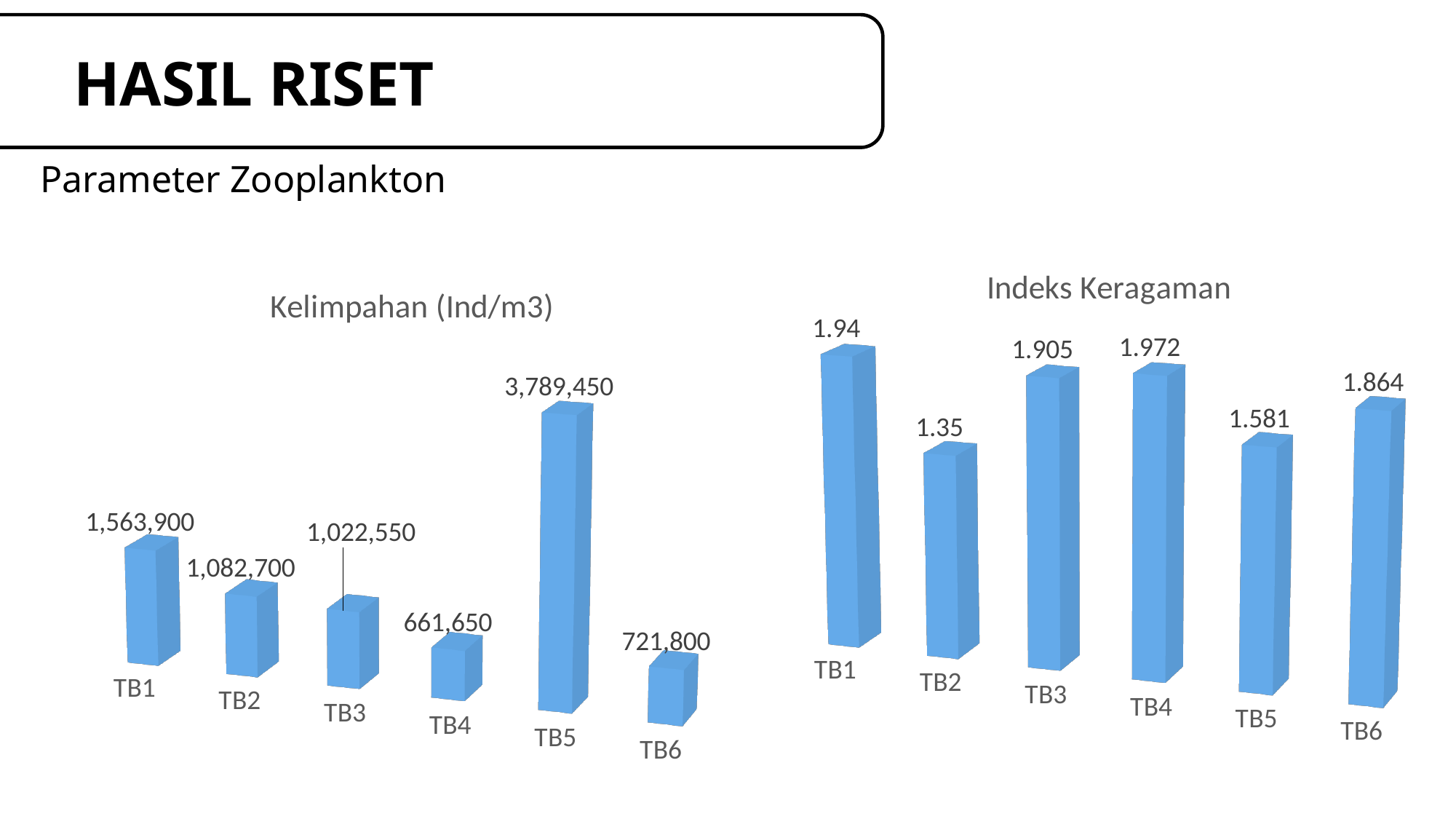
In the Indeks Keragaman chart, what is the value for TB4? 1.972 In the Indeks Keragaman chart, which station has the lowest value? TB2 In the Indeks Keragaman chart, what is the value for TB2? 1.35 In the Kelimpahan (Ind/m3) chart, what is the value for TB3? 1,022,550 In the Kelimpahan (Ind/m3) chart, which station has the lowest value? TB4 In the Indeks Keragaman chart, which is larger, TB1 or TB6? TB1 In the Kelimpahan (Ind/m3) chart, how many stations are shown? 6 In the Kelimpahan (Ind/m3) chart, what is the value for TB5? 3,789,450 In the Kelimpahan (Ind/m3) chart, what is the difference between TB1 and TB2? 481,200 In the Kelimpahan (Ind/m3) chart, which station has the highest value? TB5 What kind of chart is the Indeks Keragaman chart? Bar chart In the Indeks Keragaman chart, what is the difference between TB4 and TB5? 0.391